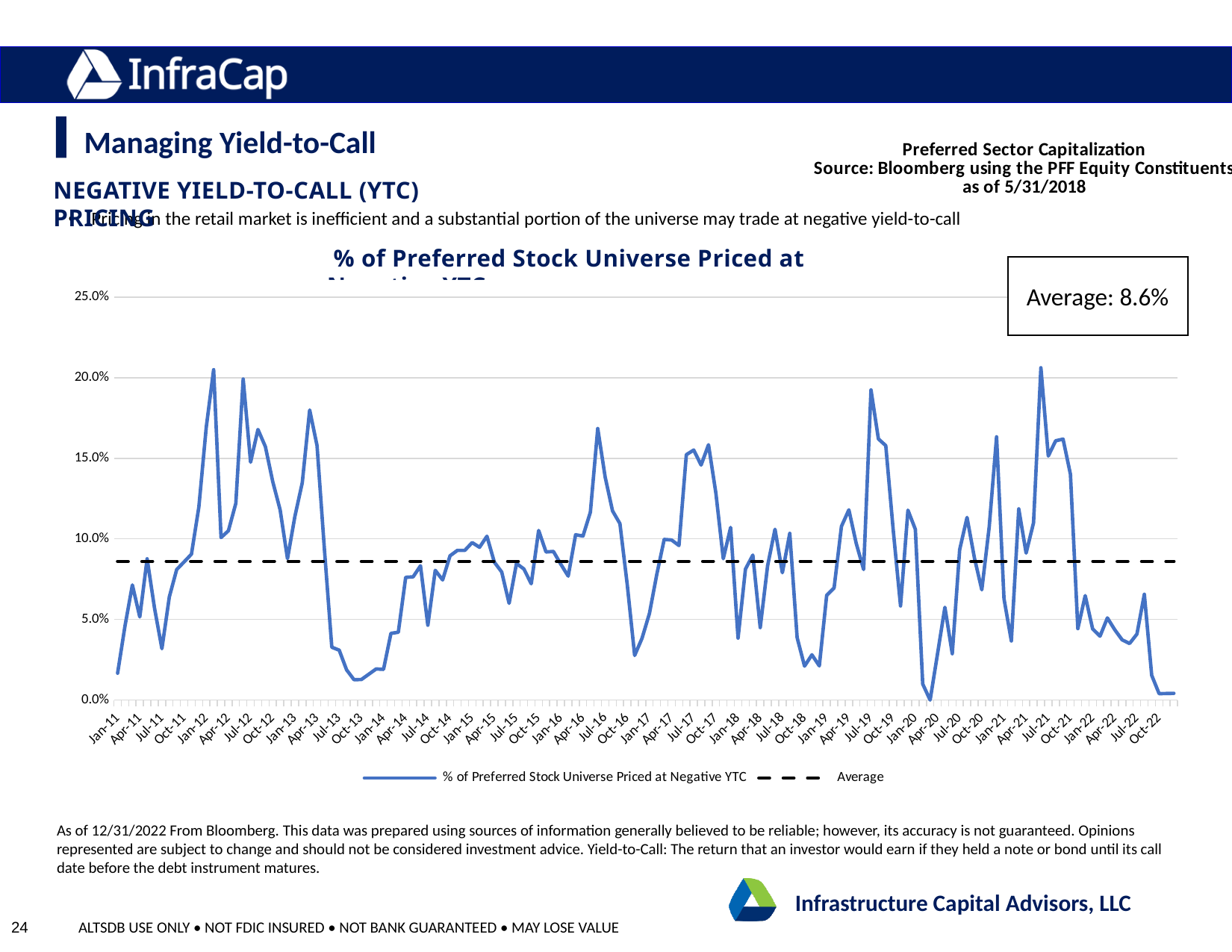
What is the highest value shown on the vertical axis of the chart? 25.0% Is the value for Jan-11 greater or less than 5.0%? less Is the value for Oct-13 greater or less than 5.0%? less Which is larger, the value for Jul-16 or the value for Jul-13? Jul-16 Is the value for Jul-19 greater or less than 15.0%? greater How many series does the chart legend list? 2 What is the average value of the % of Preferred Stock Universe Priced at Negative YTC, as shown in the annotation box? 8.6% What does the dashed line in the chart represent, according to the legend? Average What kind of chart is shown on the slide? line chart Between Jul-21 and Oct-22, do the values generally rise or fall? fall